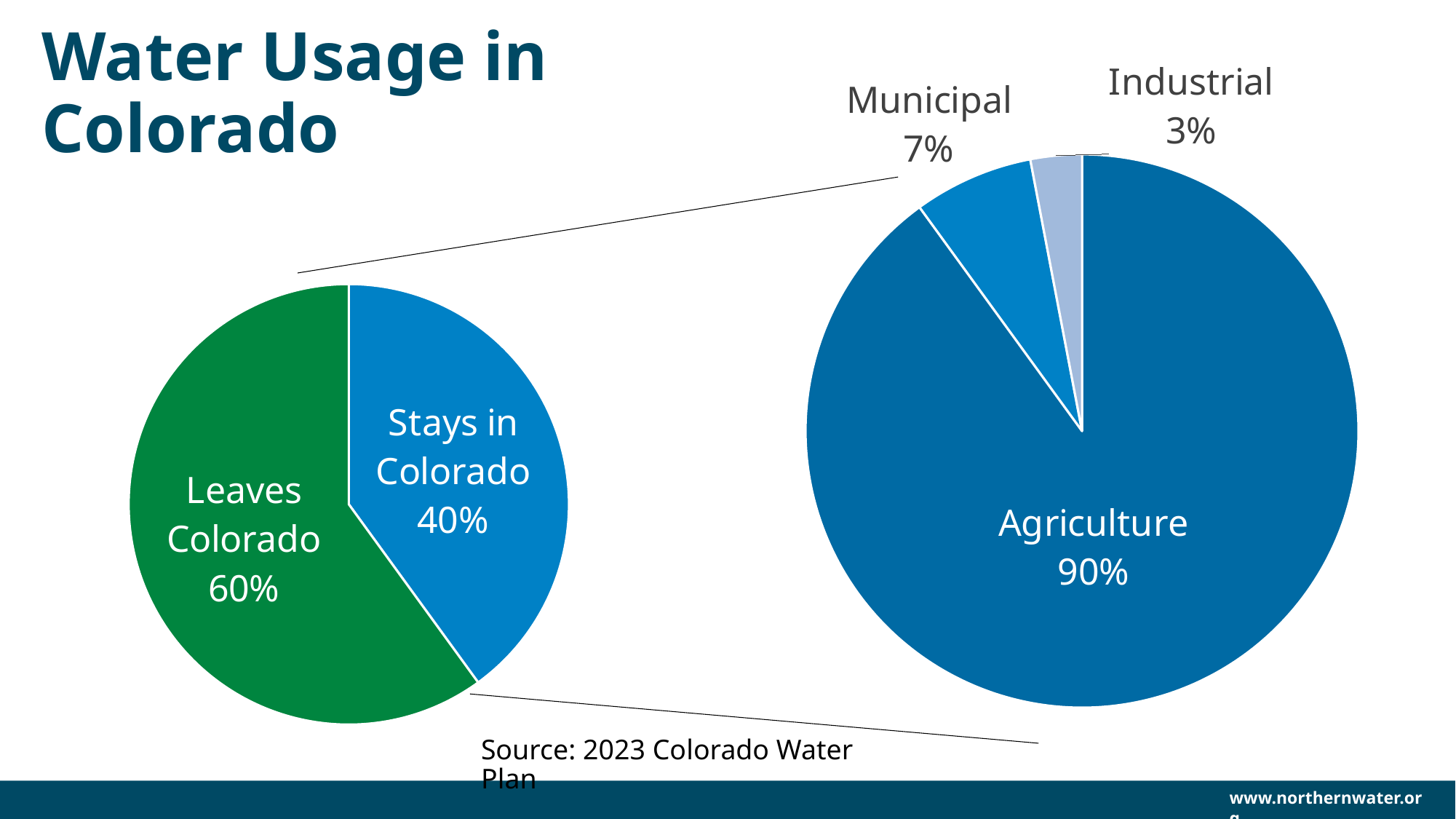
How many slices does the right pie chart have? 3 In the right pie chart, what share of water is used by Agriculture? 90% What type of chart is the left chart on the slide? Pie chart In the right pie chart, which category has the largest share? Agriculture In the left pie chart, what share of water stays in Colorado? 40% In the right pie chart, which category has the smallest share? Industrial In the right pie chart, what is the difference between the Agriculture and Municipal shares? 83% In the right pie chart, what share of water is used by Industrial? 3% In the right pie chart, what share of water is used by Municipal? 7% In the left pie chart, which is larger: the share that leaves Colorado or the share that stays in Colorado? Leaves Colorado What is the title of the slide? Water Usage in Colorado In the left pie chart, what share of water leaves Colorado? 60%